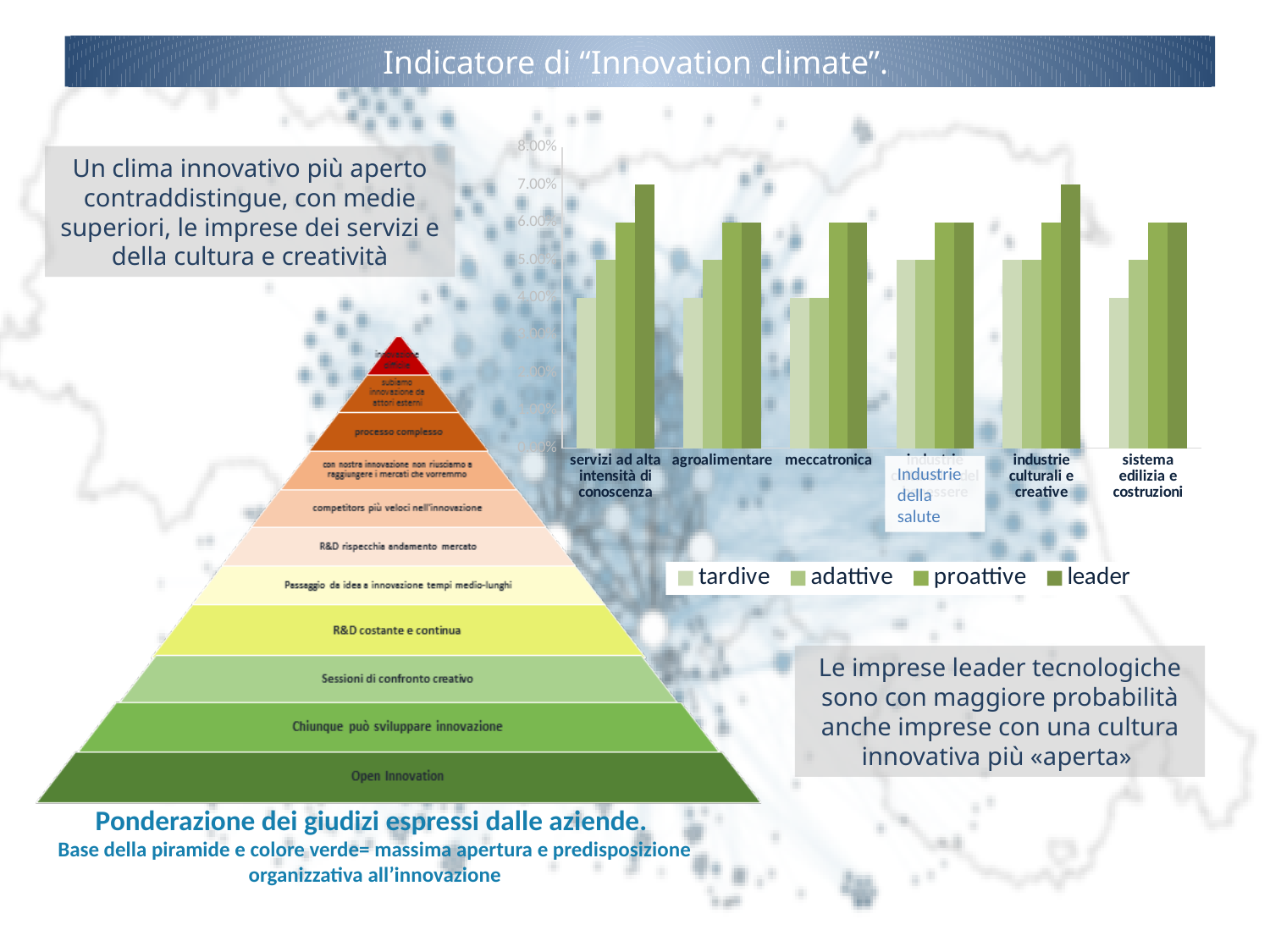
In servizi ad alta intensità di conoscenza, which is larger: the tardive bar or the leader bar? leader What are the four series named in the legend of the bar chart? tardive, adattive, proattive, leader Is the value for leader in servizi ad alta intensità di conoscenza greater or less than 6.00%? greater Is the value for tardive in sistema edilizia e costruzioni greater or less than 5.00%? less How many series does the legend of the bar chart list? 4 In servizi ad alta intensità di conoscenza, which series has the highest bar? leader What kind of chart is shown on the right side of the slide? bar chart In agroalimentare, which series has the lowest bar? tardive Within servizi ad alta intensità di conoscenza, do the bars rise or fall going from tardive to leader? rise How many sector categories are shown along the x axis of the bar chart? 6 Is the value for tardive in meccatronica greater or less than 5.00%? less